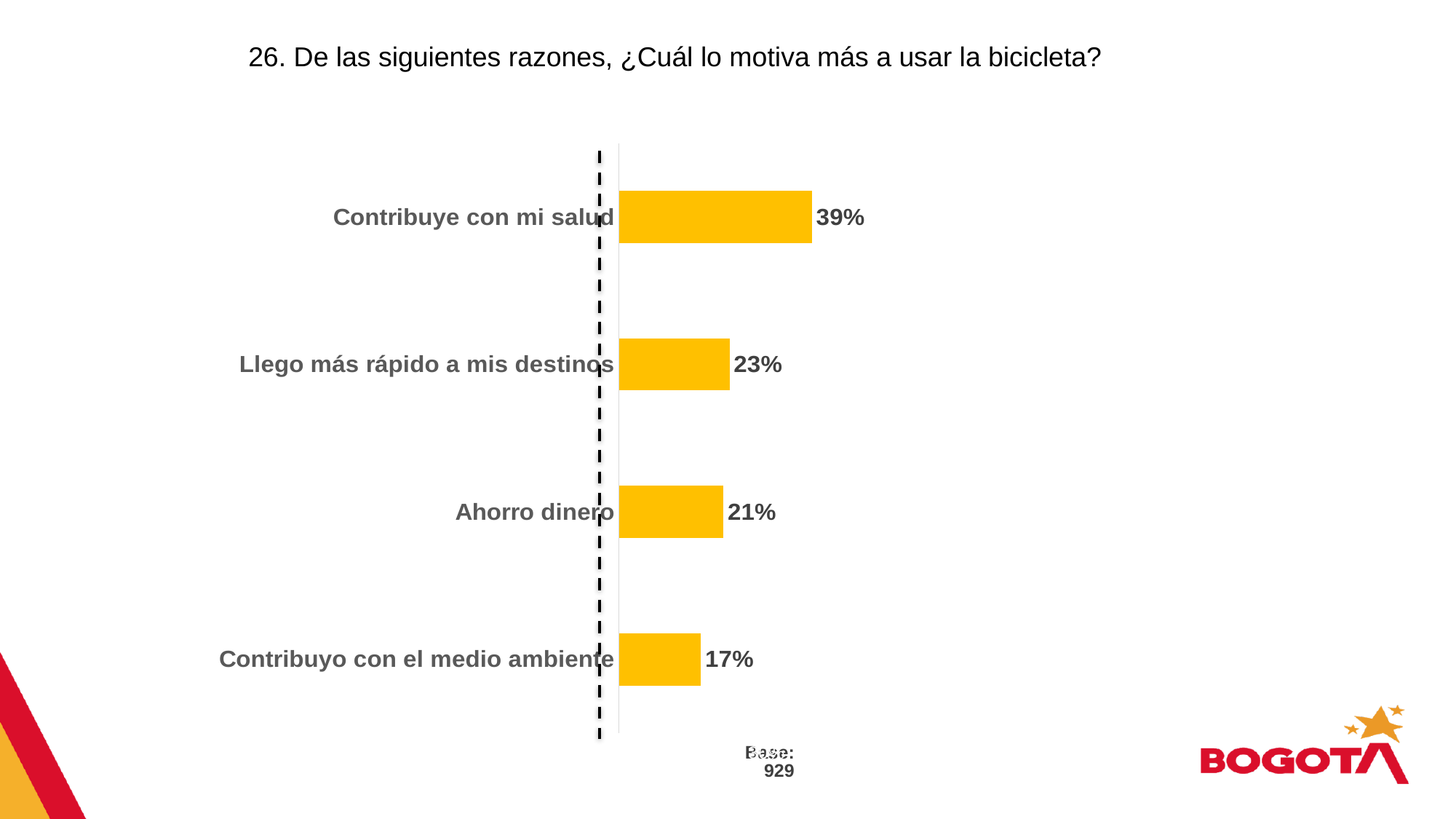
How many categories are shown in the chart? 4 What is the value for "Ahorro dinero"? 21% What is the difference between the values for "Llego más rápido a mis destinos" and "Ahorro dinero"? 2% Which is larger, the value for "Llego más rápido a mis destinos" or the value for "Contribuyo con el medio ambiente"? Llego más rápido a mis destinos What is the difference between the values for "Contribuye con mi salud" and "Contribuyo con el medio ambiente"? 22% Which category has the highest value? Contribuye con mi salud What is the value for "Contribuyo con el medio ambiente"? 17% What is the value for "Contribuye con mi salud"? 39% Which category has the lowest value? Contribuyo con el medio ambiente What is the value for "Llego más rápido a mis destinos"? 23% What is the base (number of respondents) shown below the chart? 929 What kind of chart is shown on the slide? Bar chart